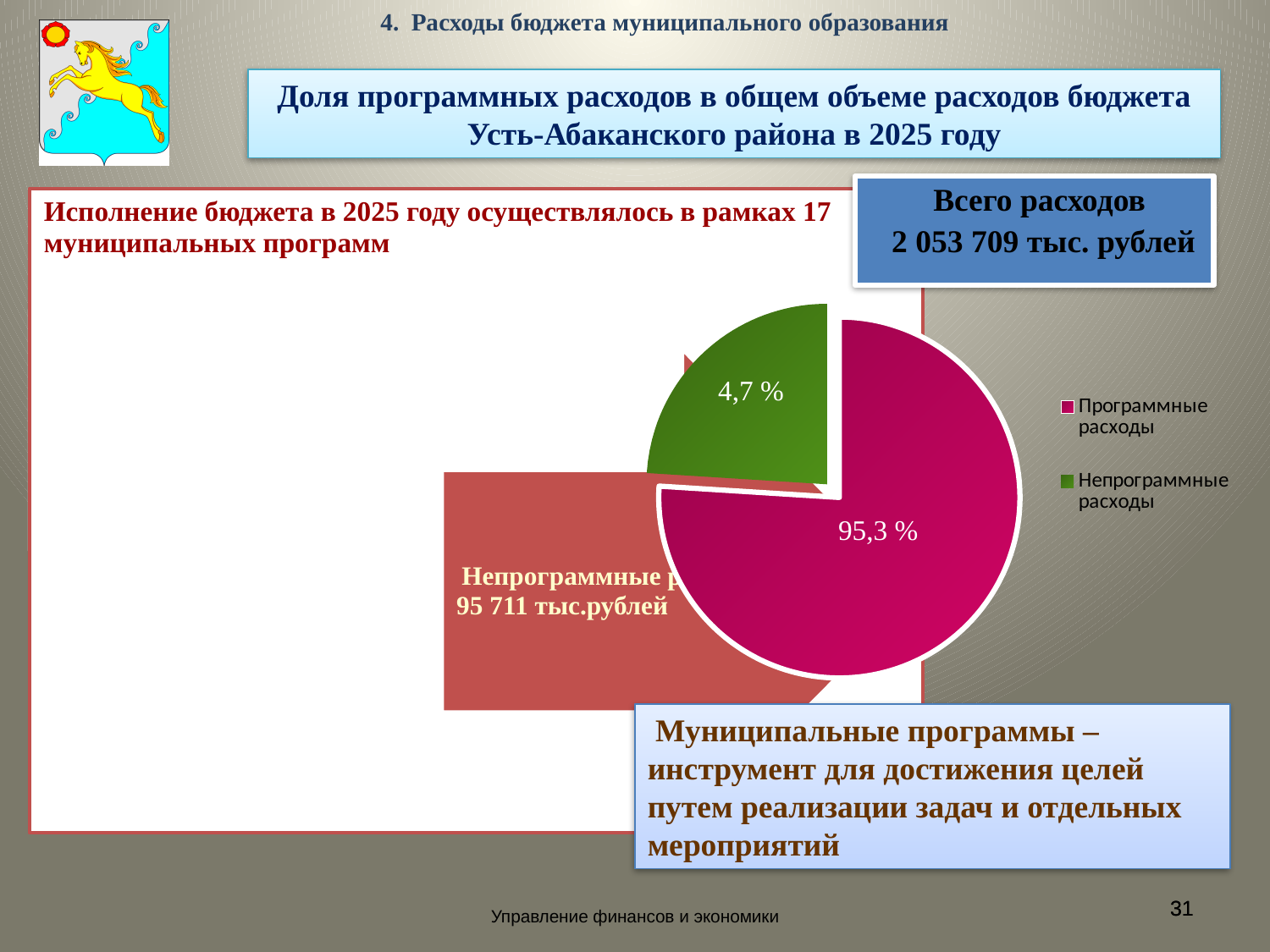
What colour is the Непрограммные расходы slice in the pie chart? green How many slices does the pie chart have? 2 Which slice of the pie is the largest? Программные расходы Which slice of the pie is the smallest? Непрограммные расходы What is the difference in percentage points between the Программные расходы share and the Непрограммные расходы share? 90,6 % What share of the pie is labelled for Непрограммные расходы? 4,7 % What colour is the Программные расходы slice in the pie chart? magenta (crimson) What kind of chart is shown on the slide? pie chart Which is larger, the share for Программные расходы or the share for Непрограммные расходы? Программные расходы What share of the pie is labelled for Программные расходы? 95,3 % How many entries does the legend list? 2